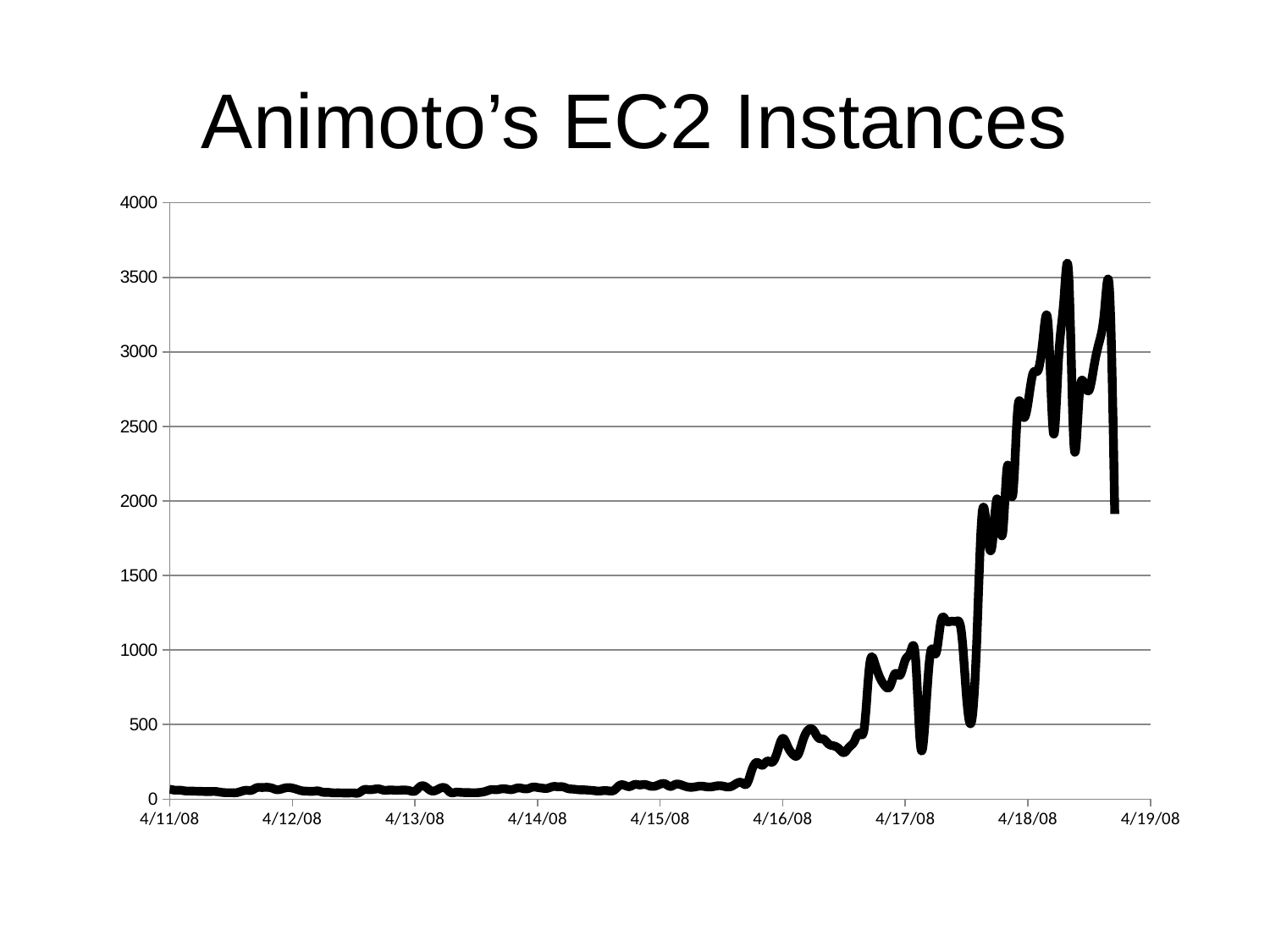
Is the value at 4/16/08 greater or less than 500? less Is the highest point on the line greater or less than 3000? greater Is the value at 4/18/08 larger than the value at 4/15/08? yes Is the value at 4/14/08 greater or less than 500? less How many date labels are shown on the x axis? 9 What kind of chart is shown on the slide? line chart What is the highest value shown on the y axis? 4000 What is the last date label on the x axis? 4/19/08 What is the title of the chart? Animoto's EC2 Instances Overall, do the values rise or fall from 4/11/08 to 4/18/08? rise